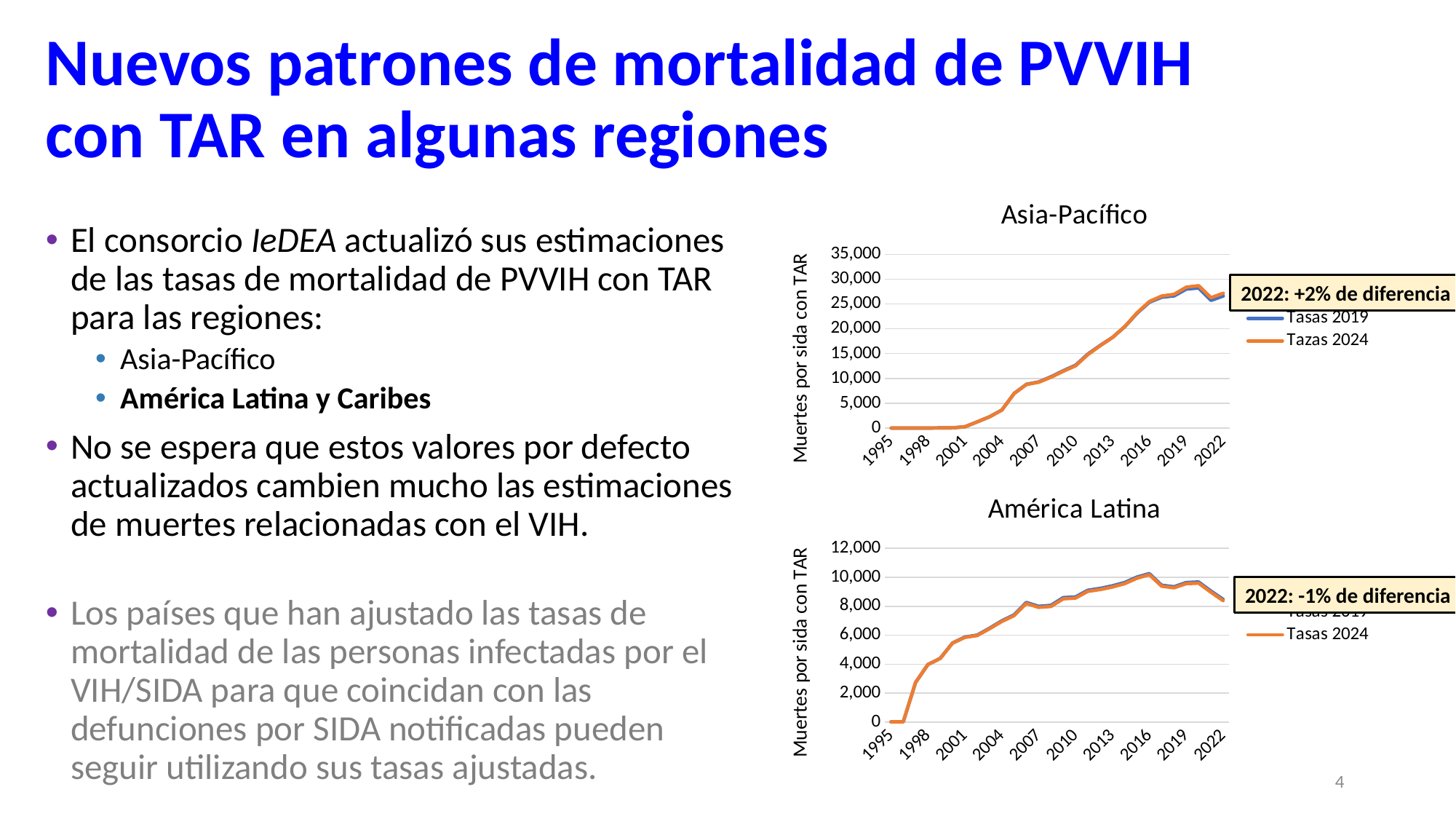
In the Asia-Pacífico chart, is the value for 2010 greater or less than 10,000? greater What kind of chart is the América Latina chart? line chart In the América Latina chart, do the values rise or fall from 2016 to 2022? fall What is the y-axis label of the América Latina chart? Muertes por sida con TAR In the Asia-Pacífico chart, do the values generally rise or fall from 1995 to 2016? rise In the Asia-Pacífico chart, is the value for 2022 greater or less than 25,000? greater In the Asia-Pacífico chart, how many series does the legend list? 2 In the América Latina chart, is the value for 2007 greater or less than 6,000? greater What kind of chart is the Asia-Pacífico chart? line chart In the Asia-Pacífico chart, what are the two legend entries? Tasas 2019 and Tazas 2024